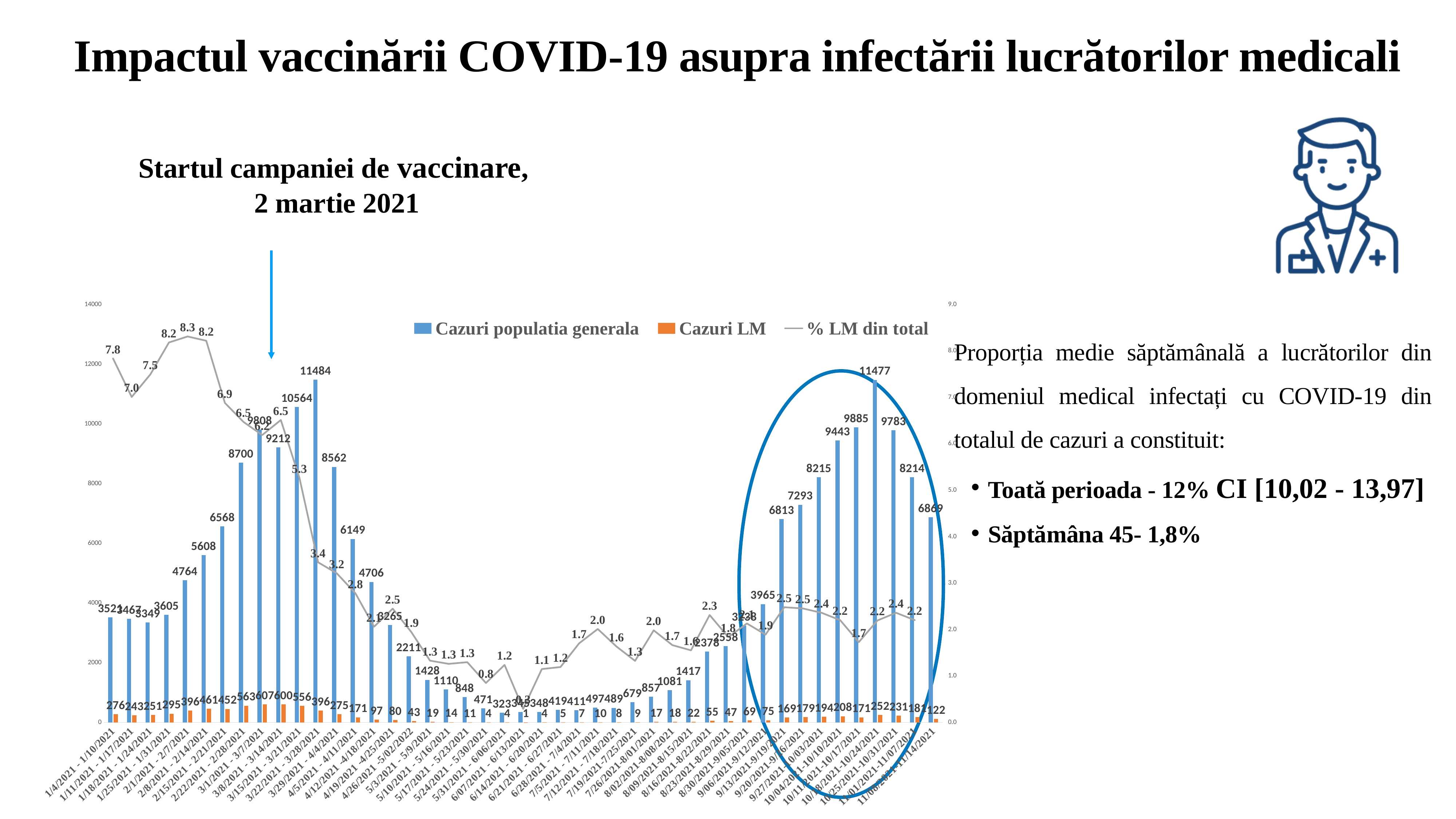
Do the Cazuri populatia generala values rise or fall from the week 9/13/2021 - 9/19/2021 to the week 10/18/2021 - 10/24/2021? rise What is the highest value of Cazuri LM shown on the chart? 607 What kind of chart is shown on the slide? A combined bar and line chart What is the difference in Cazuri populatia generala between the week 10/18/2021 - 10/24/2021 (11477) and the week 10/11/2021 - 10/17/2021 (9885)? 1592 Which week has more Cazuri populatia generala: 10/04/2021 - 10/10/2021 or 10/25/2021 - 10/31/2021? 10/25/2021 - 10/31/2021 What is the value of Cazuri LM for the week 11/08/2021 - 11/14/2021? 122 How many series does the chart legend list? 3 Is the value of Cazuri populatia generala for the week 10/18/2021 - 10/24/2021 greater or less than 10000? greater What is the highest value of the % LM din total line, and in which week does it occur? 8.3, in 2/1/2021 - 2/7/2021 How many weekly categories are plotted along the x axis? 45 What is the value of Cazuri populatia generala for the week 11/08/2021 - 11/14/2021? 6869 What is the value of Cazuri populatia generala for the week 1/4/2021 - 1/10/2021? 3521